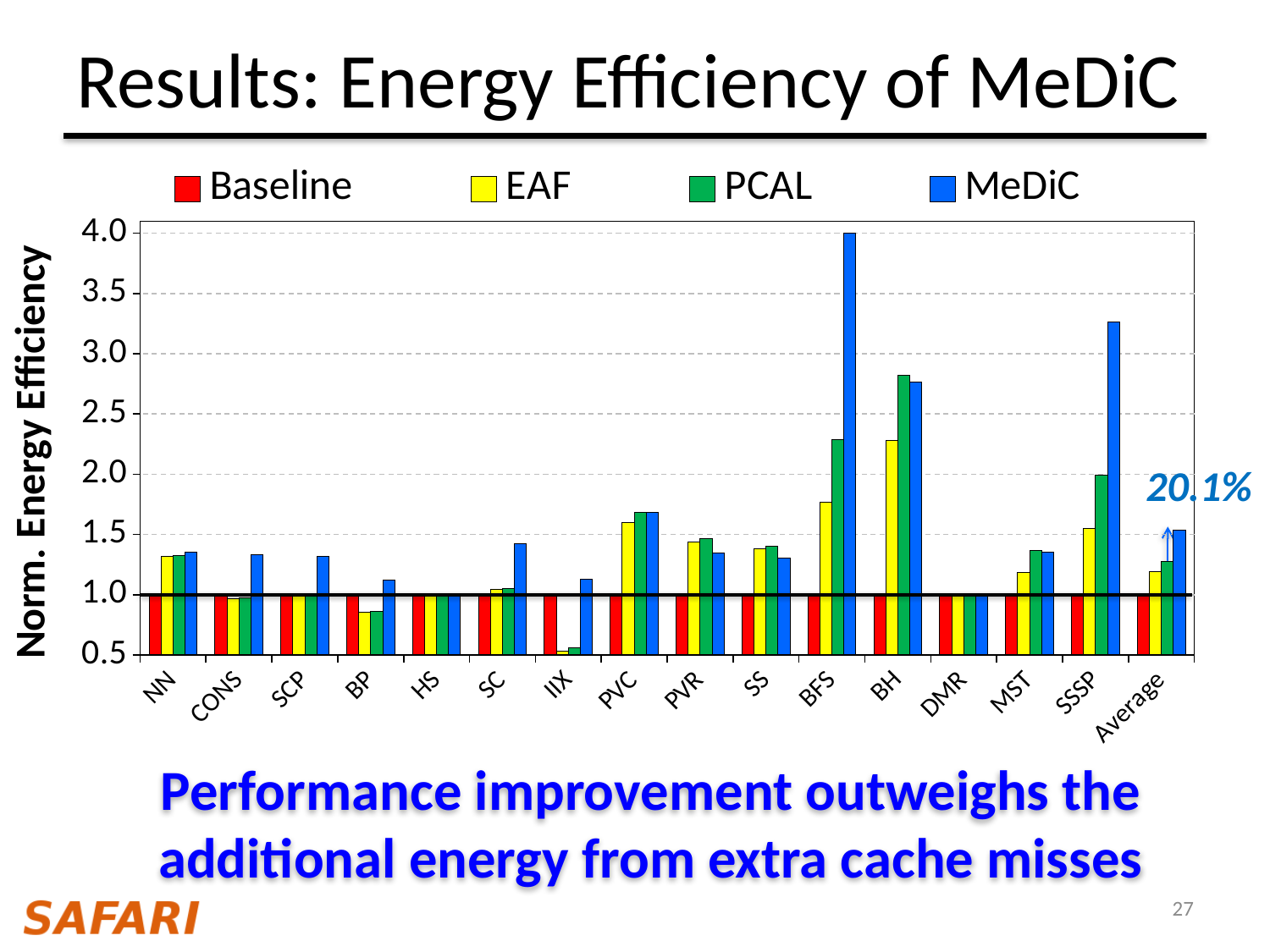
Is the MeDiC value for SSSP greater or less than 3.0? greater How many categories are shown along the x axis? 16 Is the EAF value for IIX greater or less than 1.0? less For SC, which is larger, the EAF value or the MeDiC value? MeDiC For BFS, which is larger, the EAF value or the PCAL value? PCAL Is the PCAL value for BP greater or less than 1.0? less What is the Baseline value for NN? 1.0 How many series does the legend list? 4 What percentage is annotated next to the Average bars? 20.1% Which category has the lowest EAF bar? IIX What kind of chart is shown on the slide? bar chart